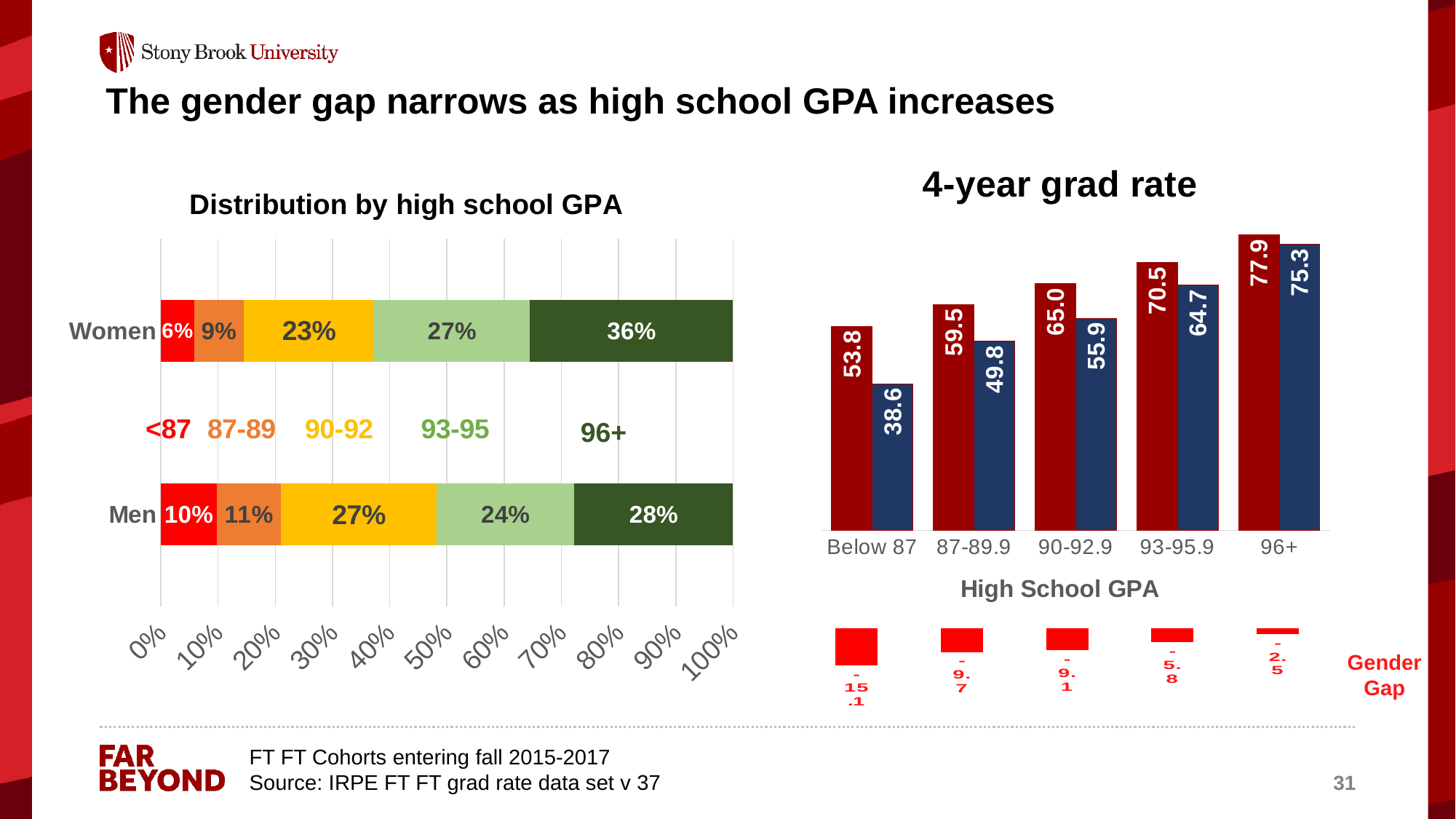
In the '4-year grad rate' chart, what is the value of the red bar for the 96+ GPA category? 77.9 In the '4-year grad rate' chart, do the red bar values rise or fall as high school GPA increases? Rise In the 'Distribution by high school GPA' chart, what is the difference between the Women and Men shares in the 96+ band? 8 percentage points What kind of chart is the 'Distribution by high school GPA' chart? Stacked bar chart In the '4-year grad rate' chart, what is the difference between the red bar and the blue bar for the 93-95.9 category? 5.8 In the '4-year grad rate' chart, which GPA category has the lowest blue bar? Below 87 In the 'Distribution by high school GPA' chart, how many GPA bands are shown? 5 In the 'Distribution by high school GPA' chart, what percentage of Men are in the <87 GPA band? 10% In the '4-year grad rate' chart, what is the Gender Gap value shown for the 90-92.9 category? -9.1 In the '4-year grad rate' chart, what is the value of the blue bar for the Below 87 category? 38.6 In the 'Distribution by high school GPA' chart, which GPA band has the largest share for Women? 96+ In the 'Distribution by high school GPA' chart, what percentage of Women are in the 96+ GPA band? 36%